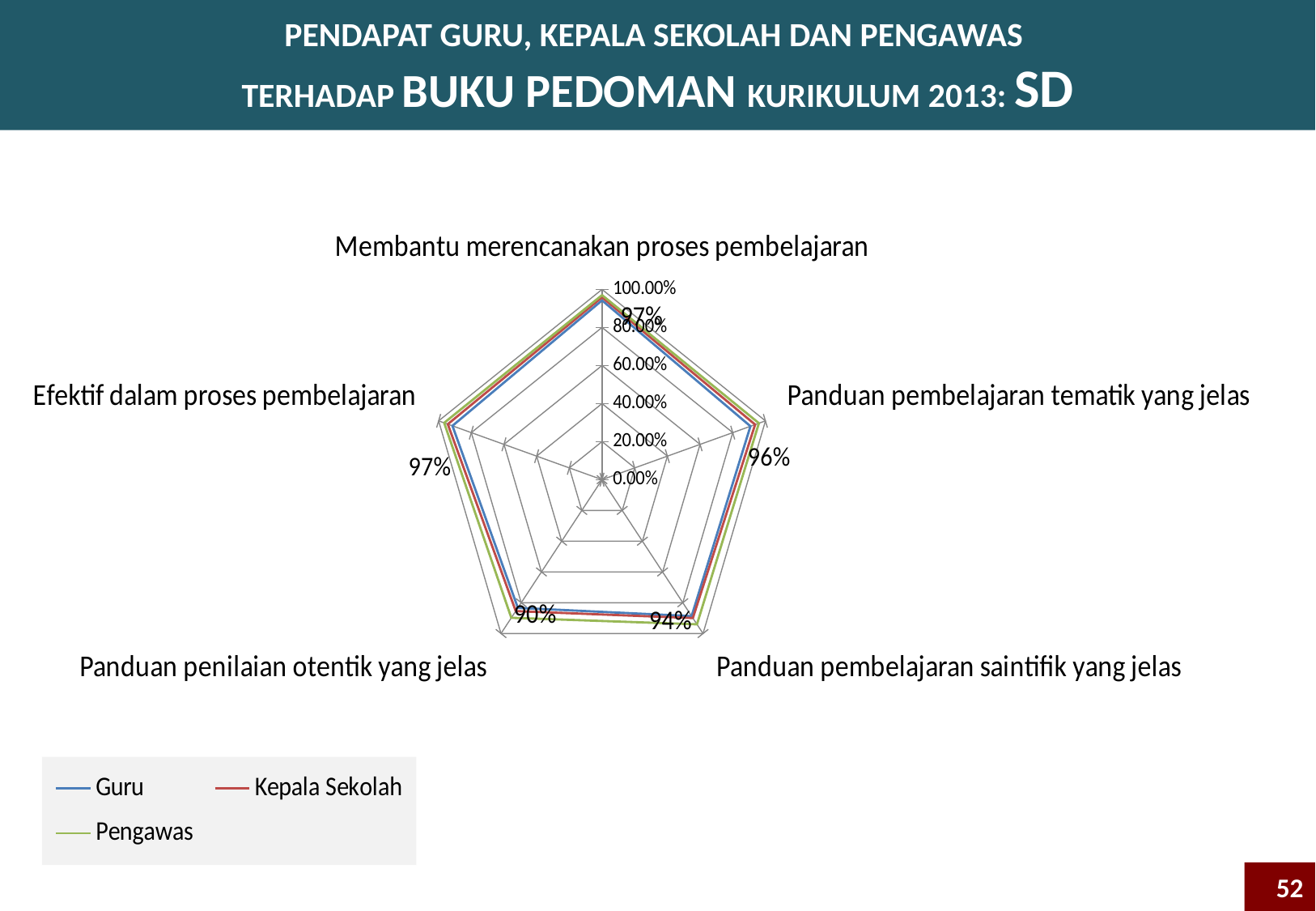
What is the difference between the labeled values for 'Panduan pembelajaran tematik yang jelas' and 'Panduan penilaian otentik yang jelas'? 6% Is the value for 'Panduan penilaian otentik yang jelas' greater or less than 80.00%? greater How many categories (axes) does the radar chart have? 5 How many series does the legend list? 3 What data label is shown at the 'Panduan pembelajaran tematik yang jelas' axis? 96% Is the labeled value for 'Panduan pembelajaran tematik yang jelas' larger or smaller than the labeled value for 'Panduan penilaian otentik yang jelas'? larger What data label is shown at the 'Panduan penilaian otentik yang jelas' axis? 90% Which category has the lowest labeled value on the chart? Panduan penilaian otentik yang jelas Which three series are listed in the chart legend? Guru, Kepala Sekolah, Pengawas What data label is shown at the 'Efektif dalam proses pembelajaran' axis? 97% What kind of chart is shown on the slide? Radar chart What data label is shown at the 'Panduan pembelajaran saintifik yang jelas' axis? 94%